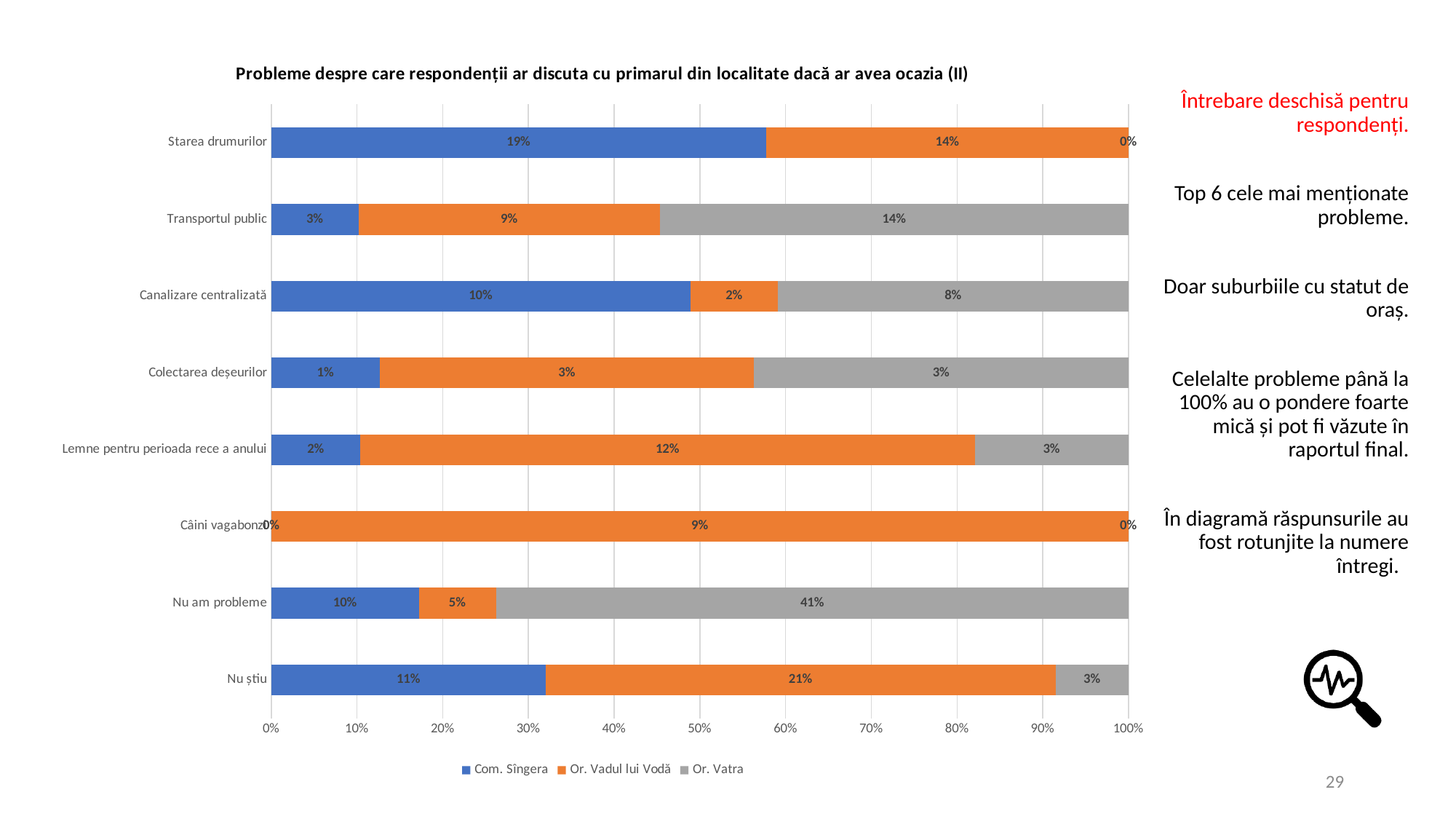
What is the value for Or. Vadul lui Vodă in the Nu știu category? 21% How many categories are shown on the y axis of the chart? 8 What is the difference between the Or. Vadul lui Vodă value and the Com. Sîngera value in the Nu știu category? 10% How many series does the legend list? 3 What is the value for Com. Sîngera in the Starea drumurilor category? 19% What is the value for Or. Vatra in the Transportul public category? 14% What kind of chart is shown on the slide? Stacked bar chart Which category has the highest value for Com. Sîngera? Starea drumurilor Which category has the highest value for Or. Vatra? Nu am probleme What is the value for Or. Vatra in the Nu am probleme category? 41% In the Canalizare centralizată category, which is larger: the value for Com. Sîngera or the value for Or. Vatra? Com. Sîngera What is the value for Or. Vadul lui Vodă in the Lemne pentru perioada rece a anului category? 12%